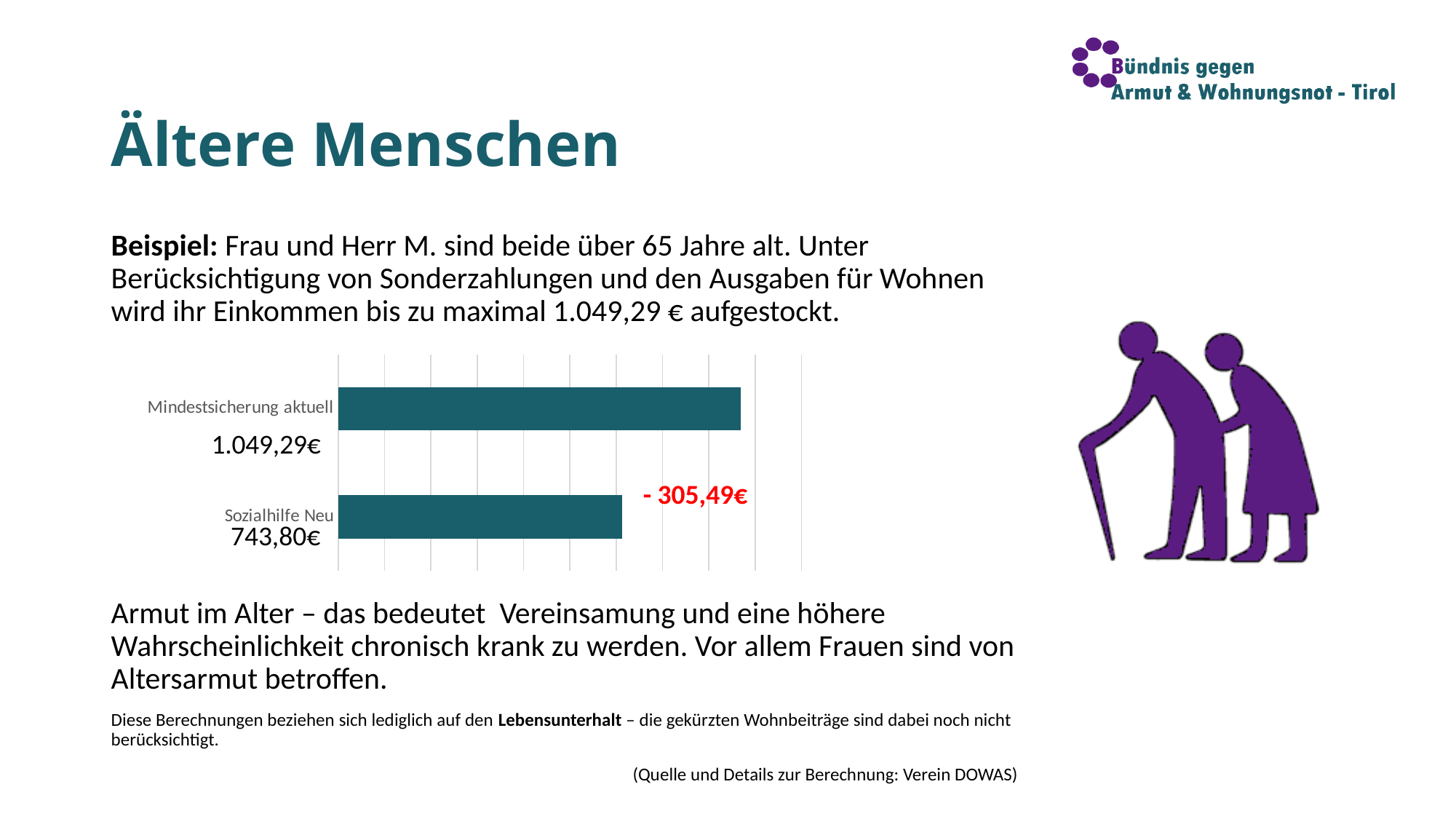
Which category has the higher value, Mindestsicherung aktuell or Sozialhilfe Neu? Mindestsicherung aktuell What is the difference between the Mindestsicherung aktuell value and the Sozialhilfe Neu value? 305,49€ What difference value is printed in red next to the Sozialhilfe Neu bar? - 305,49€ What is the value shown for Mindestsicherung aktuell? 1.049,29€ Which category has the shortest bar in the chart? Sozialhilfe Neu How many categories are shown in the bar chart? 2 What is the value shown for Sozialhilfe Neu? 743,80€ What colour are the bars in the chart? Dark teal What kind of chart is shown on the slide? Bar chart Which category has the longest bar in the chart? Mindestsicherung aktuell